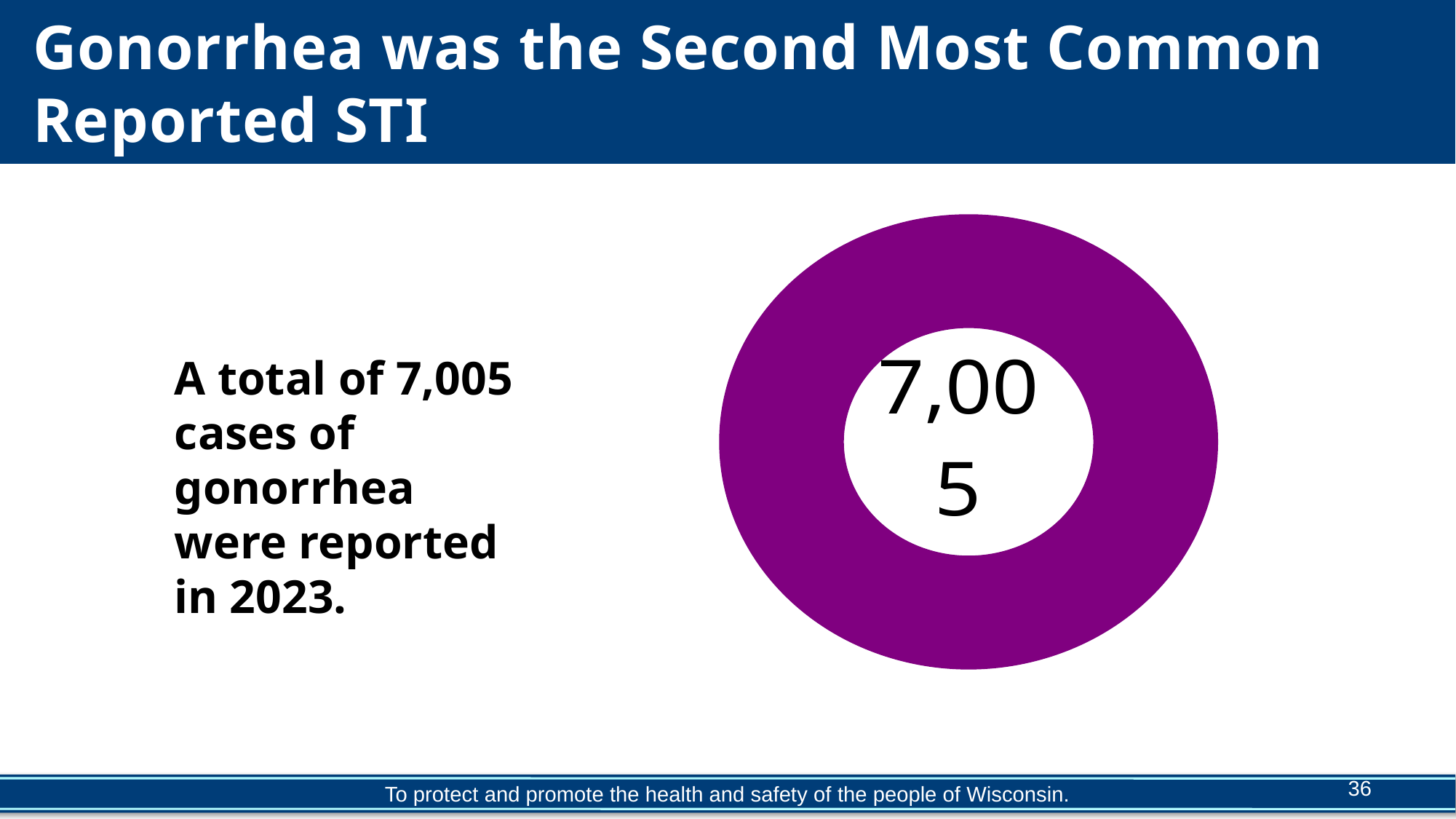
What colour is the ring of the donut chart? Purple How many cases of gonorrhea does the donut chart represent? 7,005 What value is printed in the centre of the donut chart? 7,005 What share of the donut chart does the single purple slice occupy? 100% What kind of chart is shown on the slide? Donut chart According to the slide text, in which year were the 7,005 gonorrhea cases reported? 2023 How many slices does the donut chart have? 1